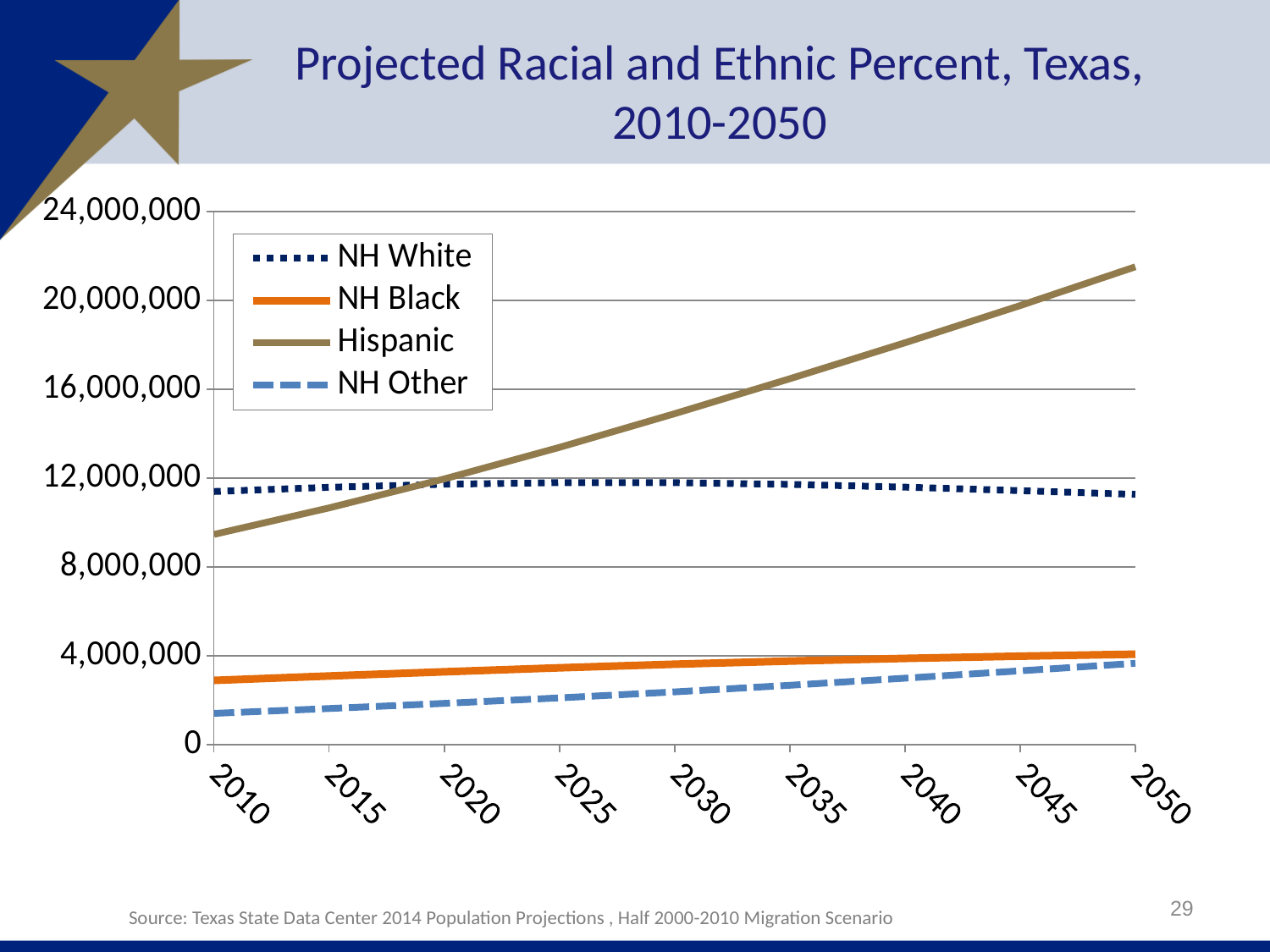
How many years are labelled along the x axis? 9 Which series has the highest value in 2050? Hispanic Is the Hispanic value in 2050 greater or less than 20,000,000? greater Does the Hispanic line rise or fall from 2010 to 2050? rise Does the NH Other line rise or fall from 2010 to 2050? rise How many series does the legend list? 4 Which series has the lowest value in 2010? NH Other What kind of chart is shown on the slide? line chart In 2010, which is larger: NH White or Hispanic? NH White Which series is drawn with a dotted line in the legend? NH White Is the Hispanic value in 2010 greater or less than 12,000,000? less Is the NH Other value in 2010 greater or less than 4,000,000? less